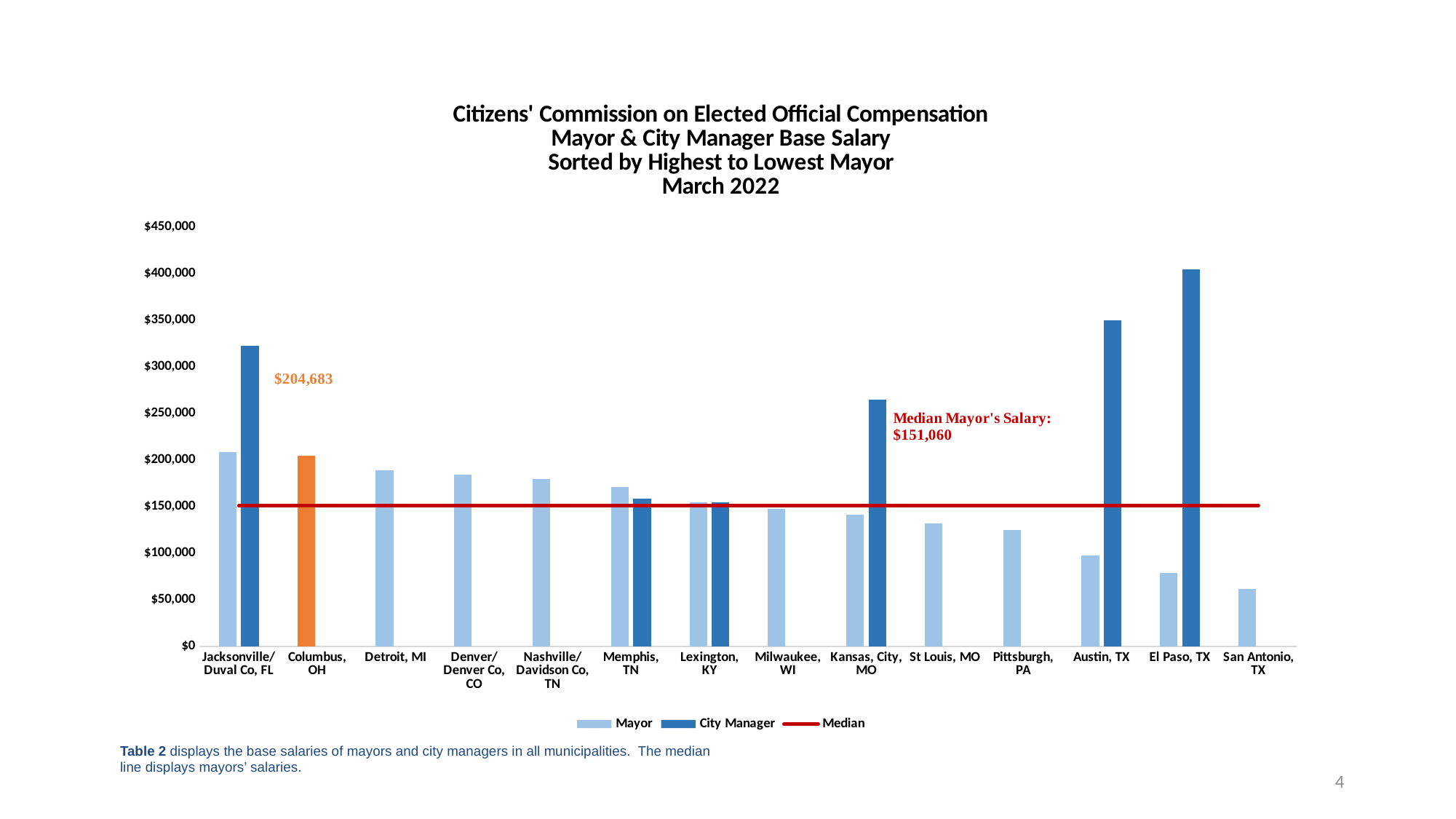
Is the City Manager salary for El Paso, TX greater or less than $350,000? greater What is the base salary shown for the Columbus, OH mayor? $204,683 How many entries does the legend list? 3 Do the Mayor salaries rise or fall from left to right along the x axis? fall Which is larger, the City Manager salary for Austin, TX or for El Paso, TX? El Paso, TX What is the median mayor's salary shown on the chart? $151,060 What kind of chart is this? bar chart Which city has the highest City Manager salary? El Paso, TX How many cities are shown on the x axis? 14 Is the City Manager salary for Kansas City, MO greater or less than $250,000? greater Is the Mayor salary for San Antonio, TX greater or less than $100,000? less Which city has the lowest Mayor salary? San Antonio, TX